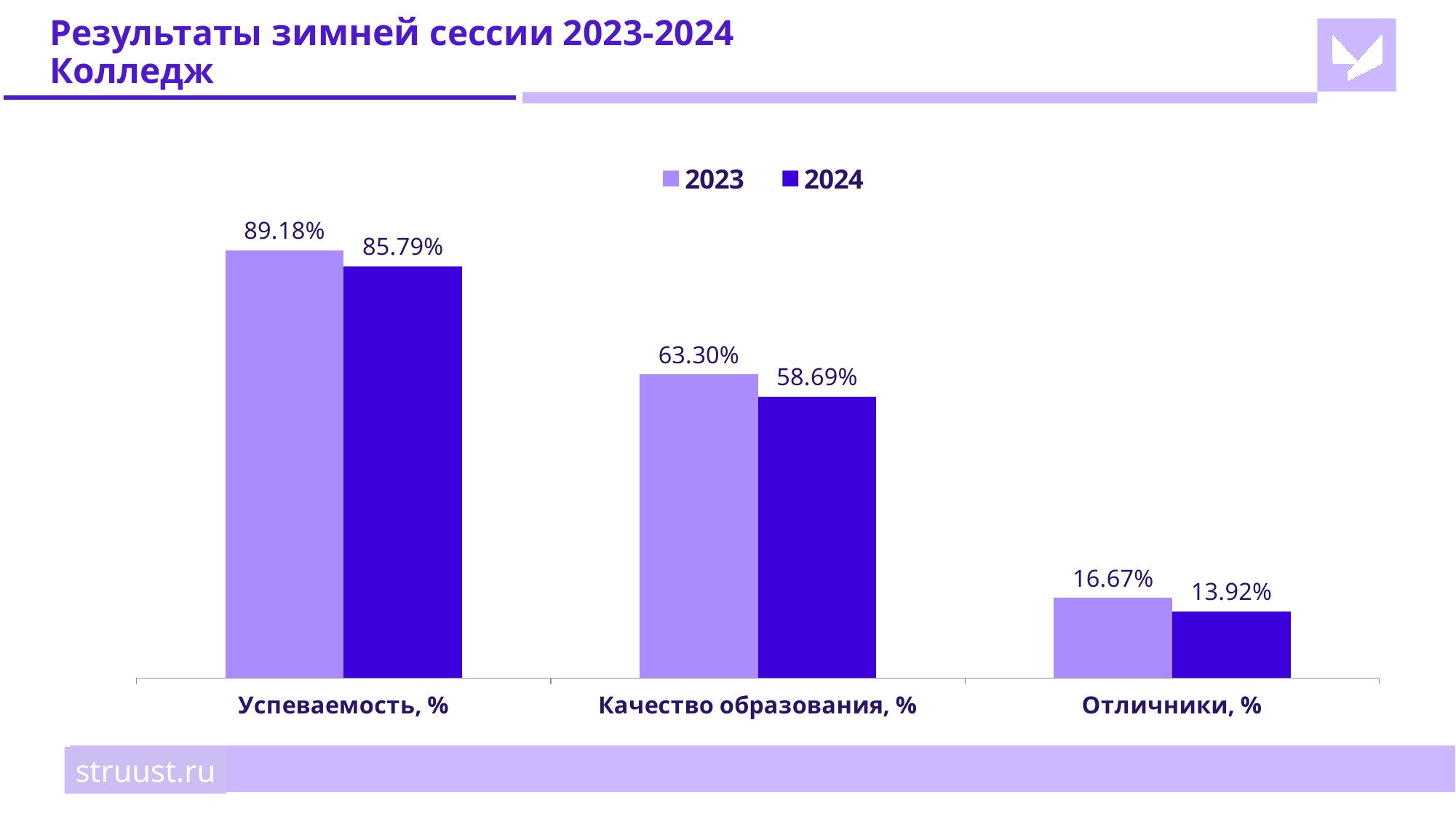
Which series is shown in the darker purple colour? 2024 What kind of chart is shown on the slide? Bar chart What is the value for Качество образования, % in 2024? 58.69% What is the value for Успеваемость, % in 2023? 89.18% Which is larger for Отличники, %: the 2023 value or the 2024 value? 2023 What is the difference between the 2023 and 2024 values for Качество образования, %? 4.61% Which category has the highest value for 2024? Успеваемость, % What is the value for Отличники, % in 2023? 16.67% How many categories are shown on the x axis? 3 Which category has the lowest value for 2023? Отличники, % What is the value for Успеваемость, % in 2024? 85.79% How many series does the legend list? 2